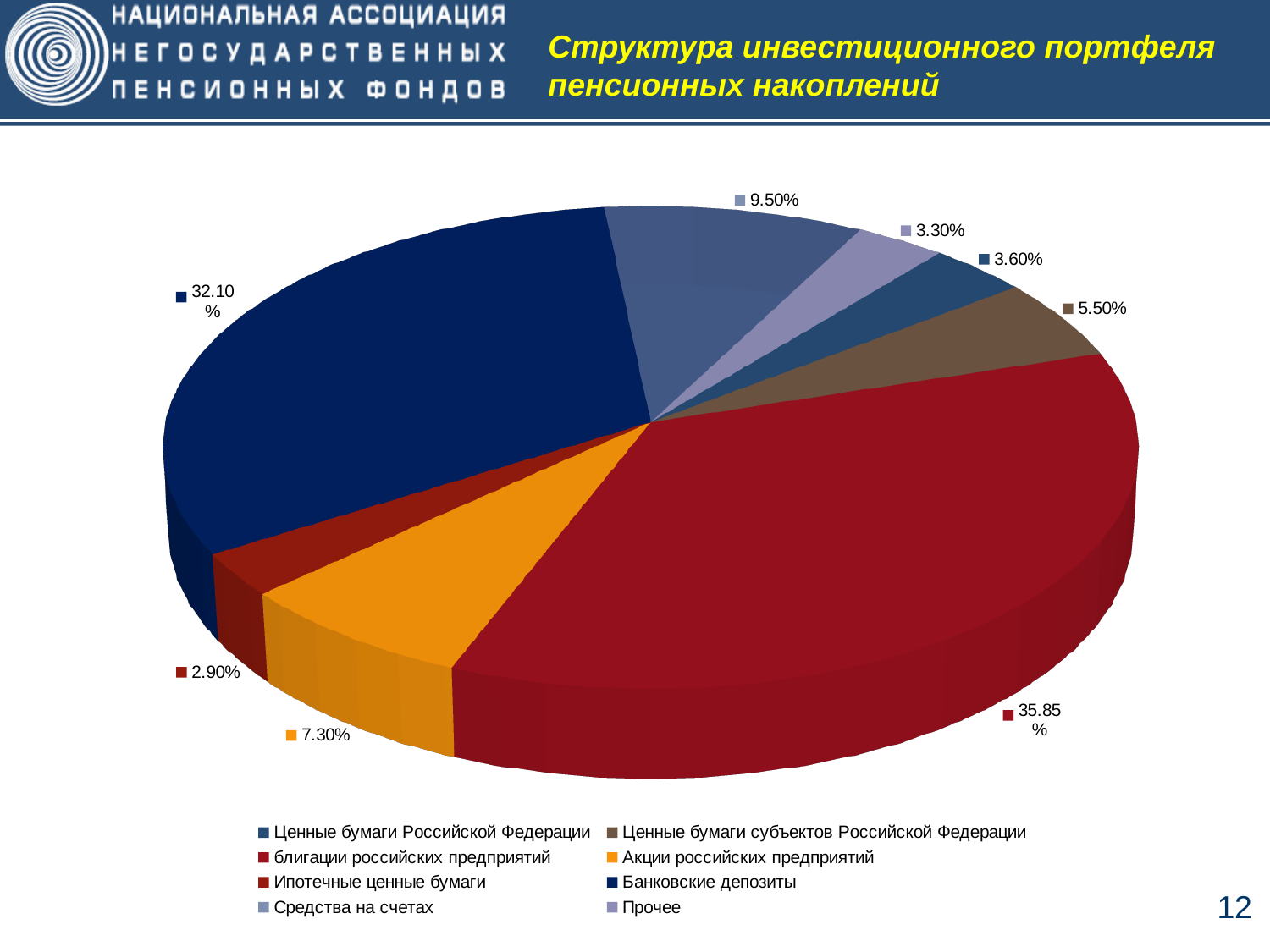
What is the value of the smallest slice of the pie chart? 2.90% What share of the pie is labelled for Акции российских предприятий? 7.30% Which is larger: the slice labelled 5.50% or the slice labelled 3.60%? 5.50% Which legend entry corresponds to the slice labelled 2.90%? Ипотечные ценные бумаги What is the difference between the largest slice (35.85%) and the slice for Банковские депозиты (32.10%)? 3.75% What is the title of the chart on the slide? Структура инвестиционного портфеля пенсионных накоплений What share of the pie is labelled for Банковские депозиты? 32.10% What share of the pie is labelled for Средства на счетах? 9.50% What type of chart is shown on the slide? pie chart How many slices does the pie chart have? 8 What is the value of the largest slice of the pie chart? 35.85% How many entries does the legend list? 8